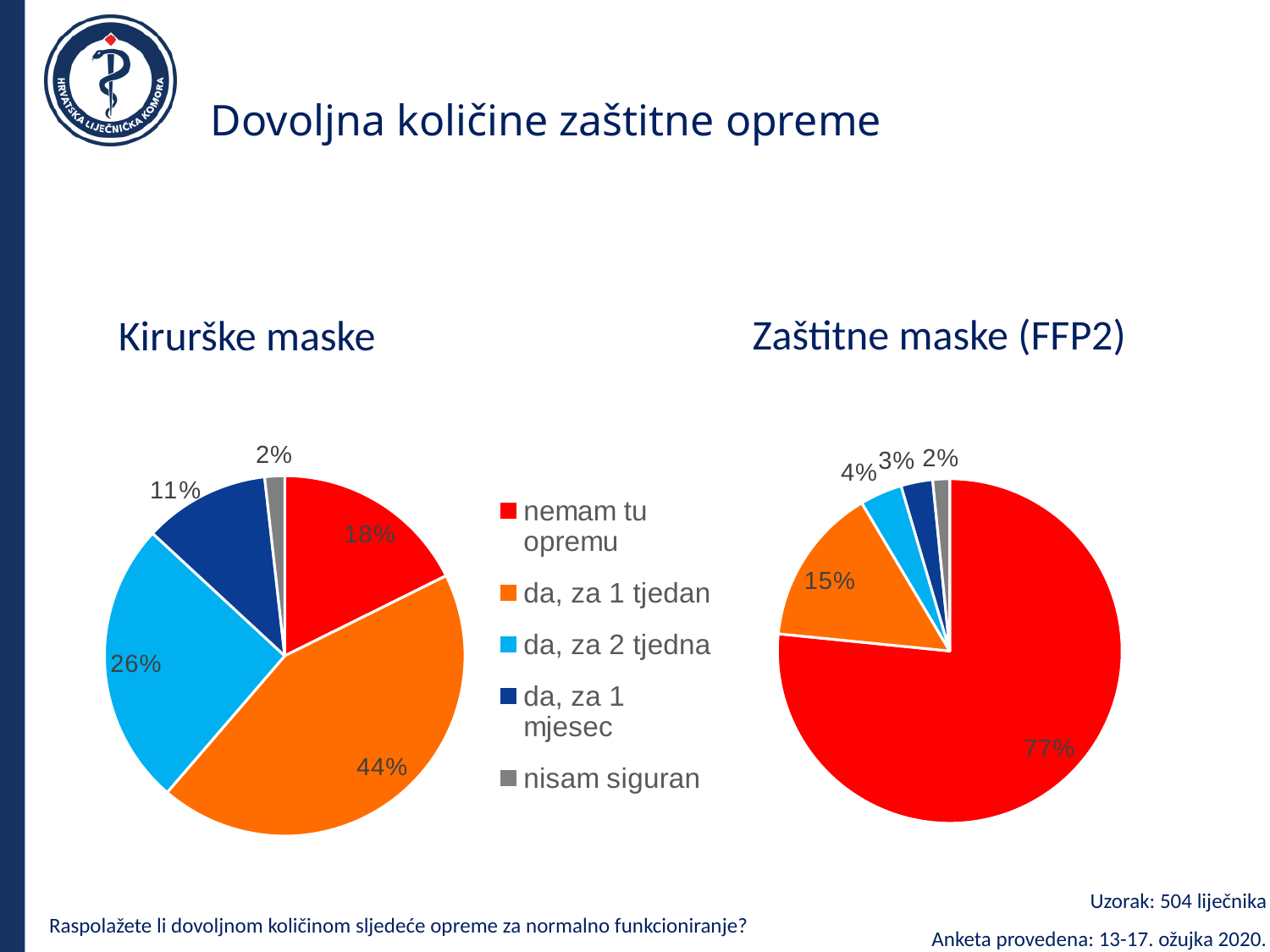
What is the difference between the 'nemam tu opremu' share in the Zaštitne maske (FFP2) chart and in the Kirurške maske chart? 59% What kind of chart is the Zaštitne maske (FFP2) chart? pie chart In the Kirurške maske chart, what share is labelled for 'da, za 1 tjedan'? 44% How many entries does the legend list? 5 In the Kirurške maske chart, which category has the largest slice? da, za 1 tjedan Which colour represents 'nisam siguran' in the legend? gray In the Zaštitne maske (FFP2) chart, which category has the smallest slice? nisam siguran How many slices does the Kirurške maske chart have? 5 In the Zaštitne maske (FFP2) chart, what share is labelled for 'da, za 1 tjedan'? 15% In the Kirurške maske chart, which is larger: 'da, za 2 tjedna' or 'nemam tu opremu'? da, za 2 tjedna In the Kirurške maske chart, what share is labelled for 'da, za 2 tjedna'? 26% In the Zaštitne maske (FFP2) chart, what share is labelled for 'nemam tu opremu'? 77%